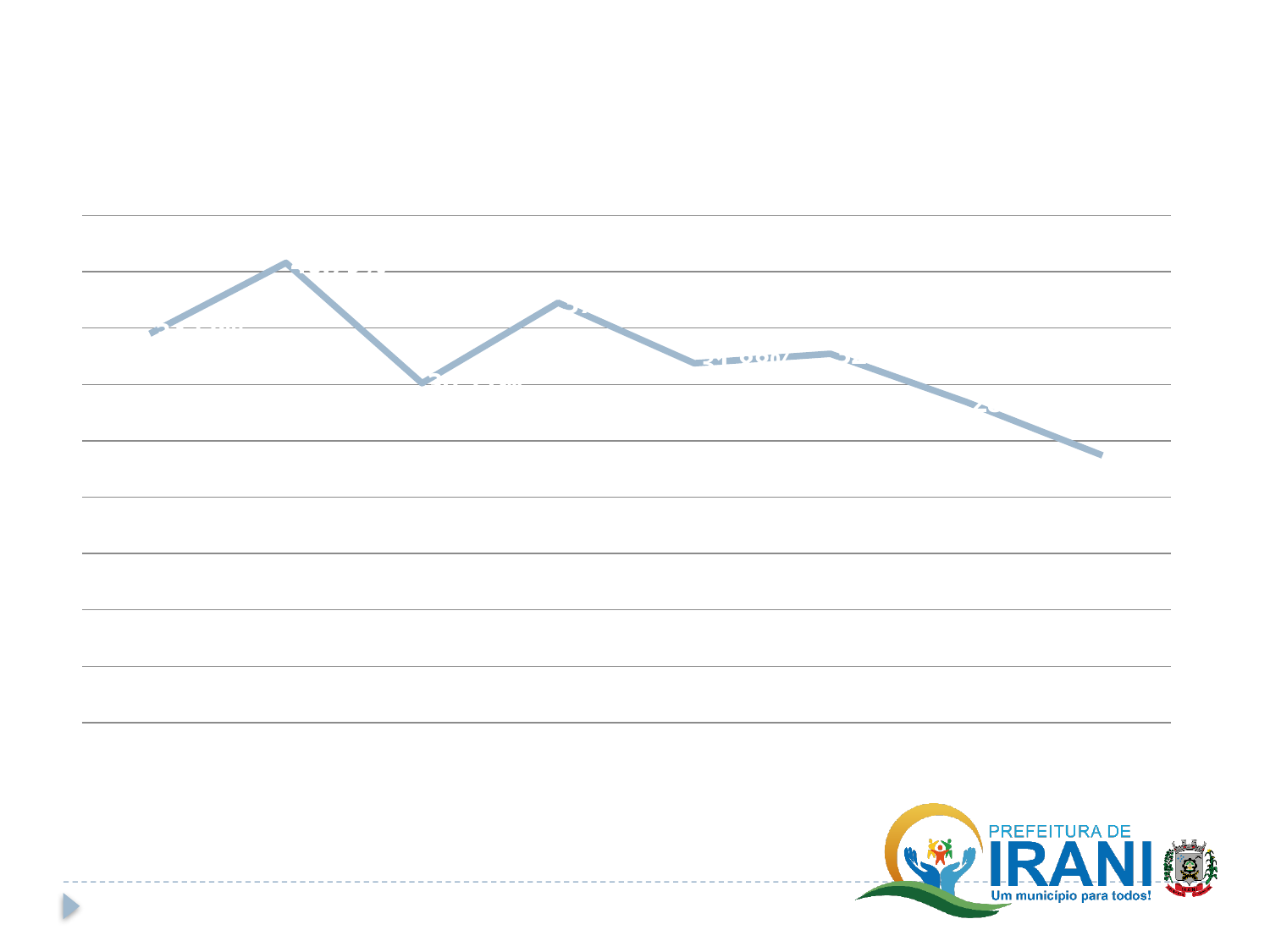
Which point on the line is the lowest: the first, third, or last? the last What kind of chart is shown on the slide? line chart How many lines (series) are plotted on the chart? 1 Is the second point on the line higher or lower than the first point? higher Is the last point on the line higher or lower than the third point? lower How many data points are plotted on the line? 8 Which point on the line is the highest: the first, second, or last? the second Overall, do the values rise or fall from the first point to the last point along the x axis? fall